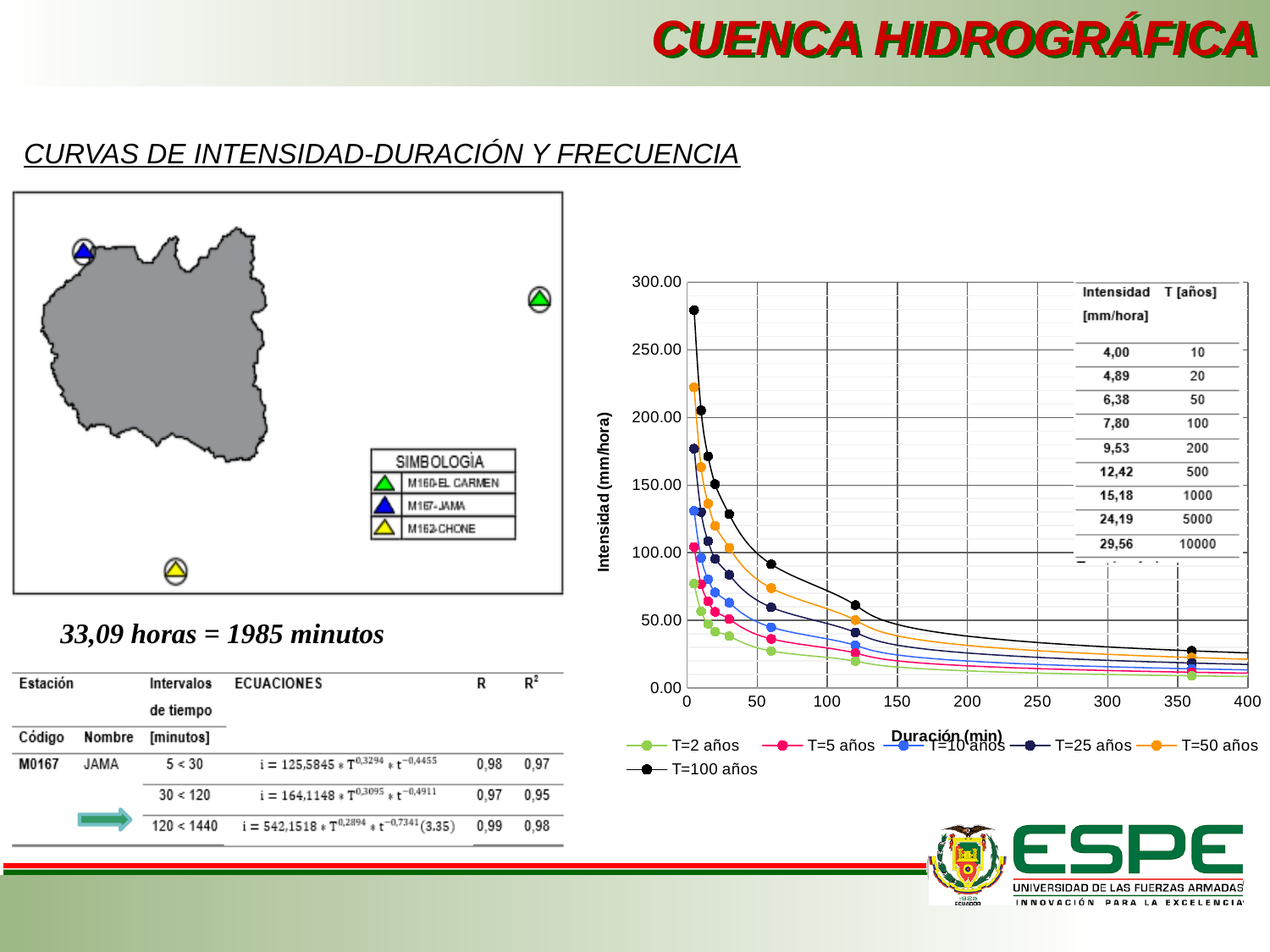
In the intensity-duration chart, is the first point of the T=2 años series greater or less than 100? less In the intensity-duration chart, is the T=5 años value at a duration of 60 min greater or less than 50? less What is the title of the vertical axis of the intensity-duration chart? Intensidad (mm/hora) How many series does the legend of the intensity-duration chart list? 6 In the intensity-duration chart, do the values rise or fall as duration increases along the x axis? fall Which series in the intensity-duration chart has the highest intensity values? T=100 años What is the title of the horizontal axis of the intensity-duration chart? Duración (min) In the intensity-duration chart, is the first point of the T=100 años series greater or less than 250? greater Which series in the intensity-duration chart has the lowest intensity values? T=2 años What kind of chart is shown on the right of the slide? line chart In the intensity-duration chart, which series has the larger value at a duration of 5 min: T=100 años or T=2 años? T=100 años